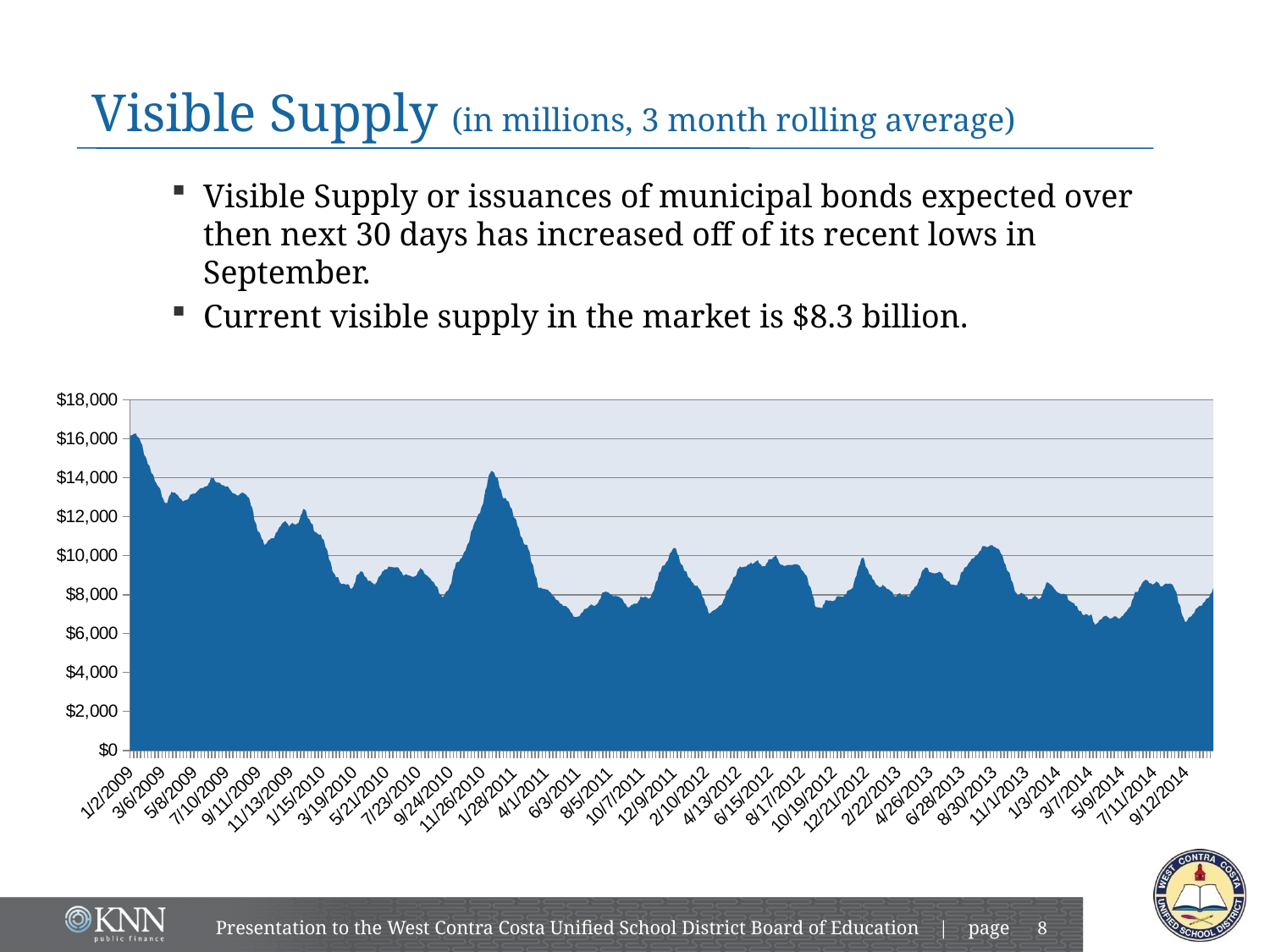
Which is larger, the value at 1/28/2011 or the value at 6/3/2011? 1/28/2011 What kind of chart is shown on the slide? Area chart Is the value at 1/2/2009 greater or less than $14,000? greater Is the value at 7/10/2009 greater or less than $12,000? greater Is the value at 6/3/2011 greater or less than $8,000? less At which x-axis date does the chart reach its highest value? 1/2/2009 Overall, do the values rise or fall from 1/2/2009 to 9/12/2014? fall Which is larger, the value at 1/2/2009 or the value at 9/12/2014? 1/2/2009 What is the highest value shown on the y axis? $18,000